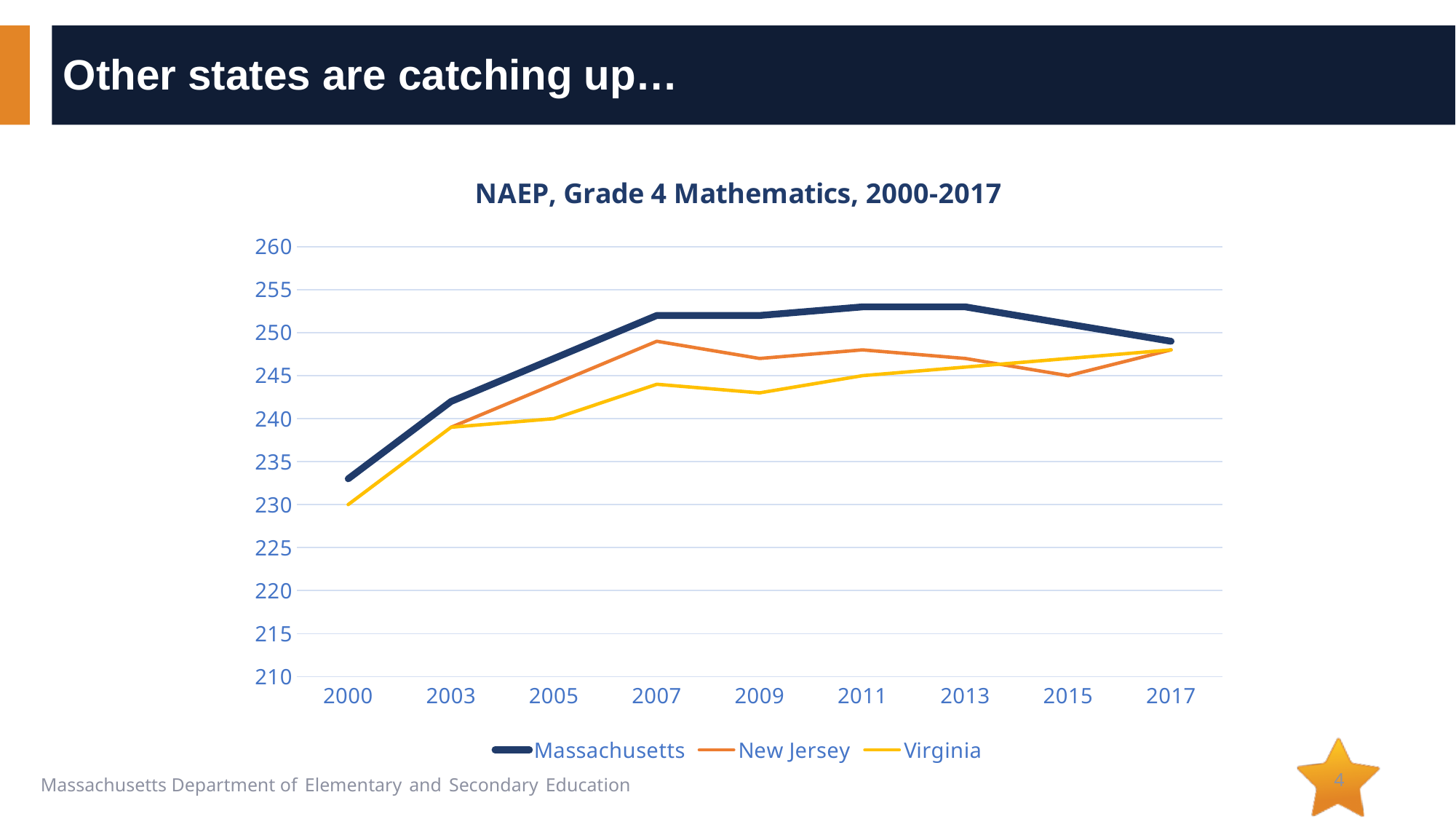
How many years are shown on the x axis? 9 How many series does the legend list? 3 In 2009, which is larger: the value for New Jersey or the value for Virginia? New Jersey Which series is drawn with the thick dark blue line? Massachusetts What is the title of the chart? NAEP, Grade 4 Mathematics, 2000-2017 Is the value for New Jersey in 2015 greater or less than 240? greater Is the value for Massachusetts in 2000 greater or less than 235? less Is the value for Massachusetts in 2013 greater or less than 250? greater In which year is the Massachusetts value lowest? 2000 What kind of chart is shown on the slide? line chart Which series has the highest value in 2007? Massachusetts